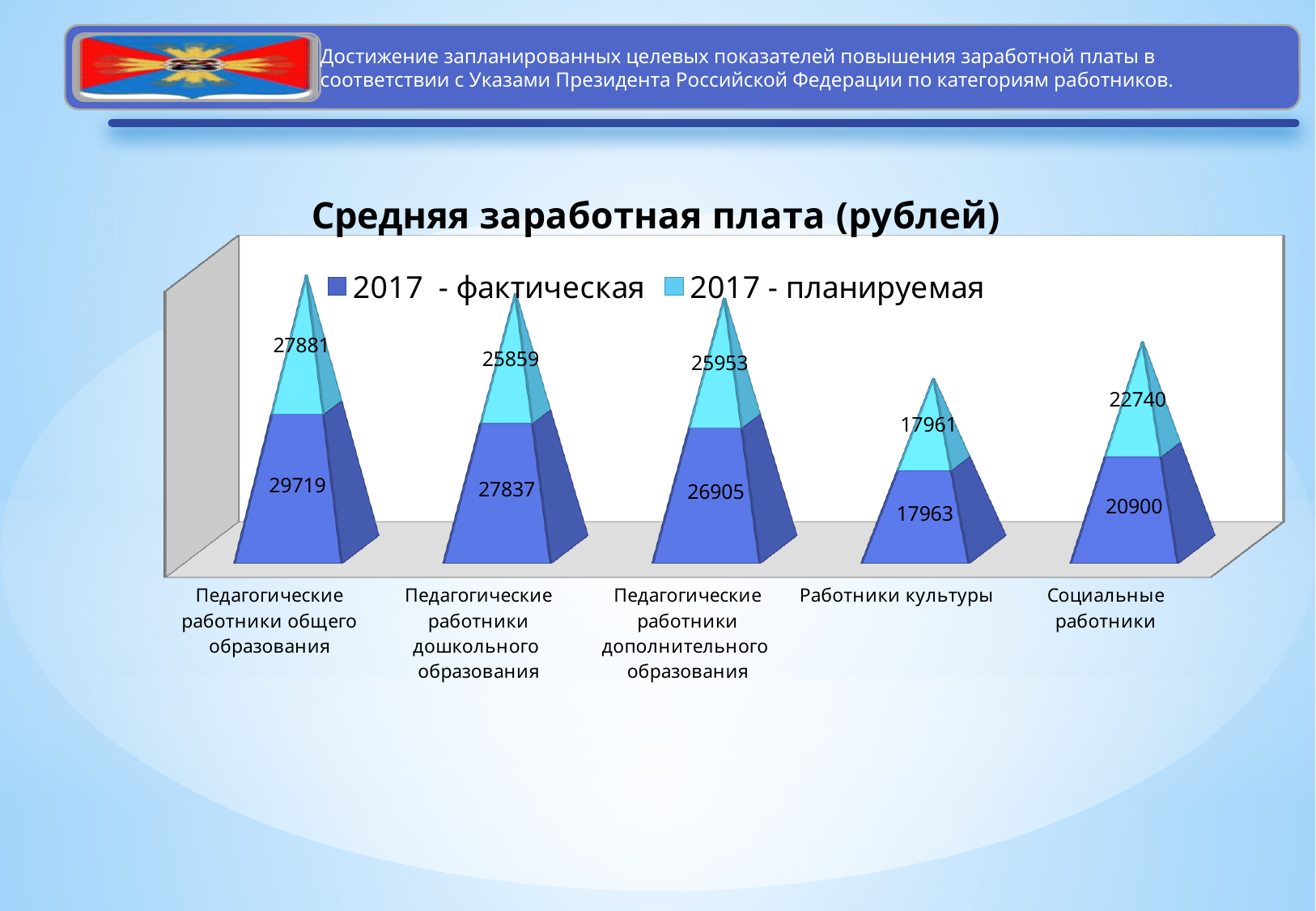
Which category has the highest value in the "2017 - фактическая" series? Педагогические работники общего образования What kind of chart is shown on the slide? Stacked bar chart How many categories are shown on the x axis of the chart? 5 How many series does the legend list? 2 What is the title of the chart? Средняя заработная плата (рублей) What is the total of the two stacked segments for "Работники культуры"? 35924 For "Социальные работники", which is larger: the "2017 - фактическая" value or the "2017 - планируемая" value? 2017 - планируемая What is the value of the "2017 - фактическая" series for "Работники культуры"? 17963 Which category has the lowest value in the "2017 - планируемая" series? Работники культуры What is the value of the "2017 - планируемая" series for "Социальные работники"? 22740 What is the value of the "2017 - фактическая" series for "Педагогические работники общего образования"? 29719 What is the difference between the "2017 - фактическая" and "2017 - планируемая" values for "Педагогические работники общего образования"? 1838